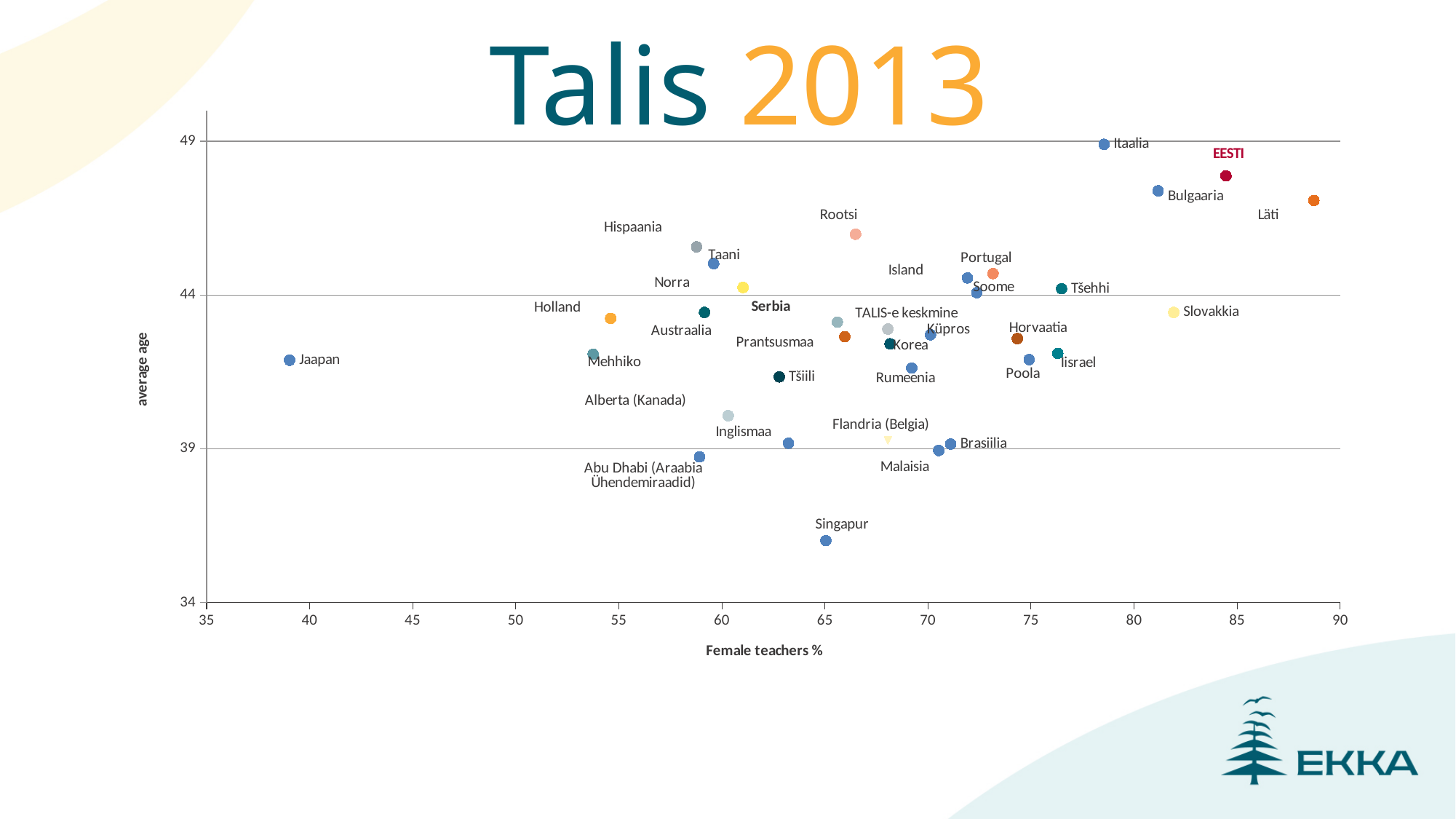
Which country has the highest percentage of female teachers? Läti Is the female teachers % for Jaapan greater or less than 40? less Which has a higher female teachers %, Läti or EESTI? Läti Which country has the lowest percentage of female teachers? Jaapan Is the average age for Rootsi greater or less than 44? greater Which country has the lowest average age in the chart? Singapur Is the female teachers % for Mehhiko greater or less than 55? less Which has a higher average age, Itaalia or Bulgaaria? Itaalia Which country has the highest average age in the chart? Itaalia What kind of chart is shown on the slide? scatter chart What is the label of the horizontal axis of the chart? Female teachers %